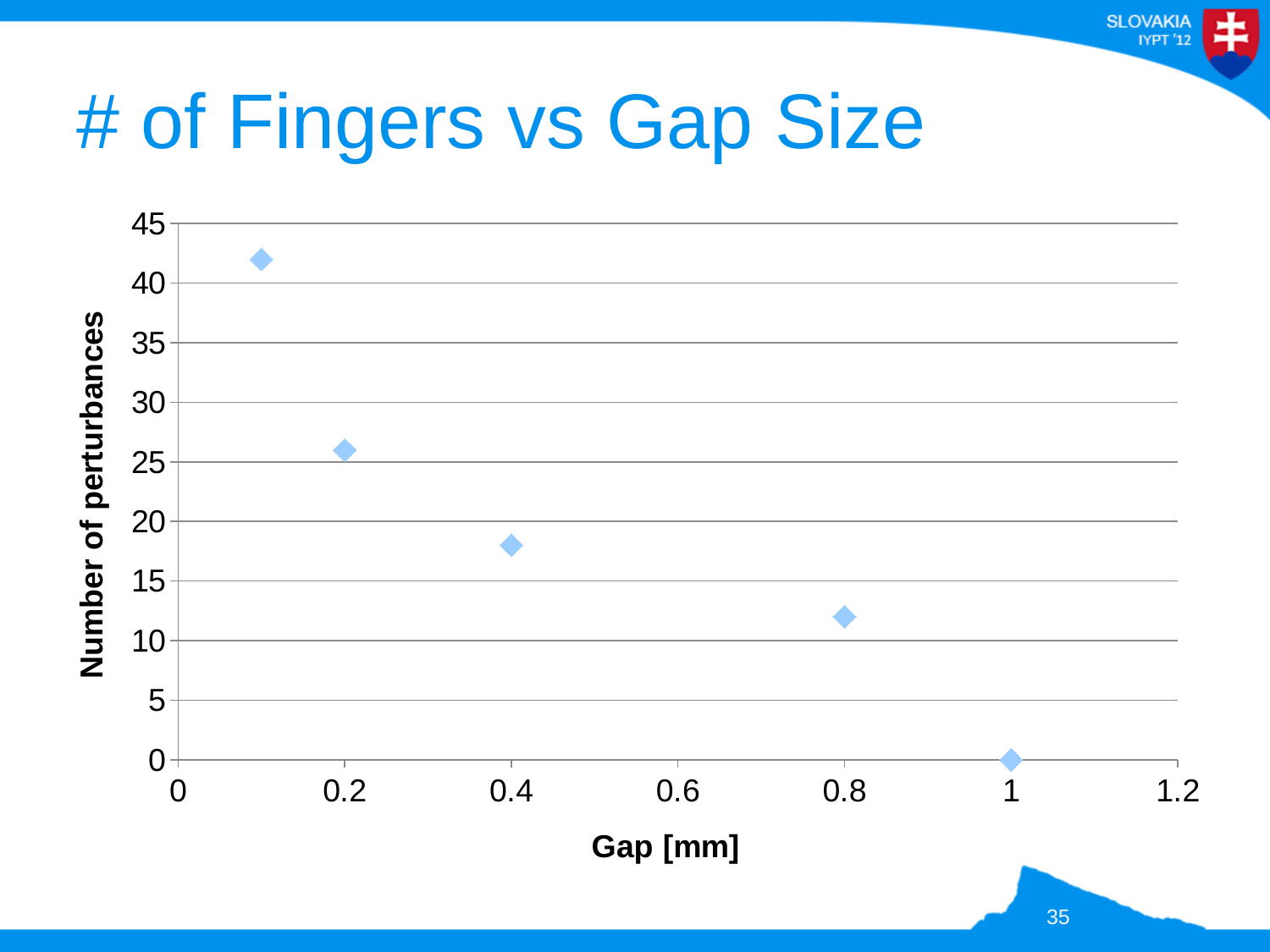
What is the number of perturbances at a gap of 1 mm? 0 Is the number of perturbances at a gap of 0.1 mm greater or less than 40? greater Is the number of perturbances at a gap of 0.2 mm greater or less than 25? greater At which gap size is the number of perturbances highest? 0.1 mm Is the number of perturbances at a gap of 0.4 mm greater or less than 20? less What is the label of the x axis? Gap [mm] At which gap size is the number of perturbances lowest? 1 mm What kind of chart is shown on the slide? scatter chart How many data points are plotted on the chart? 5 Does the number of perturbances rise or fall as the gap size increases? fall Which has more perturbances: a gap of 0.2 mm or a gap of 0.4 mm? 0.2 mm